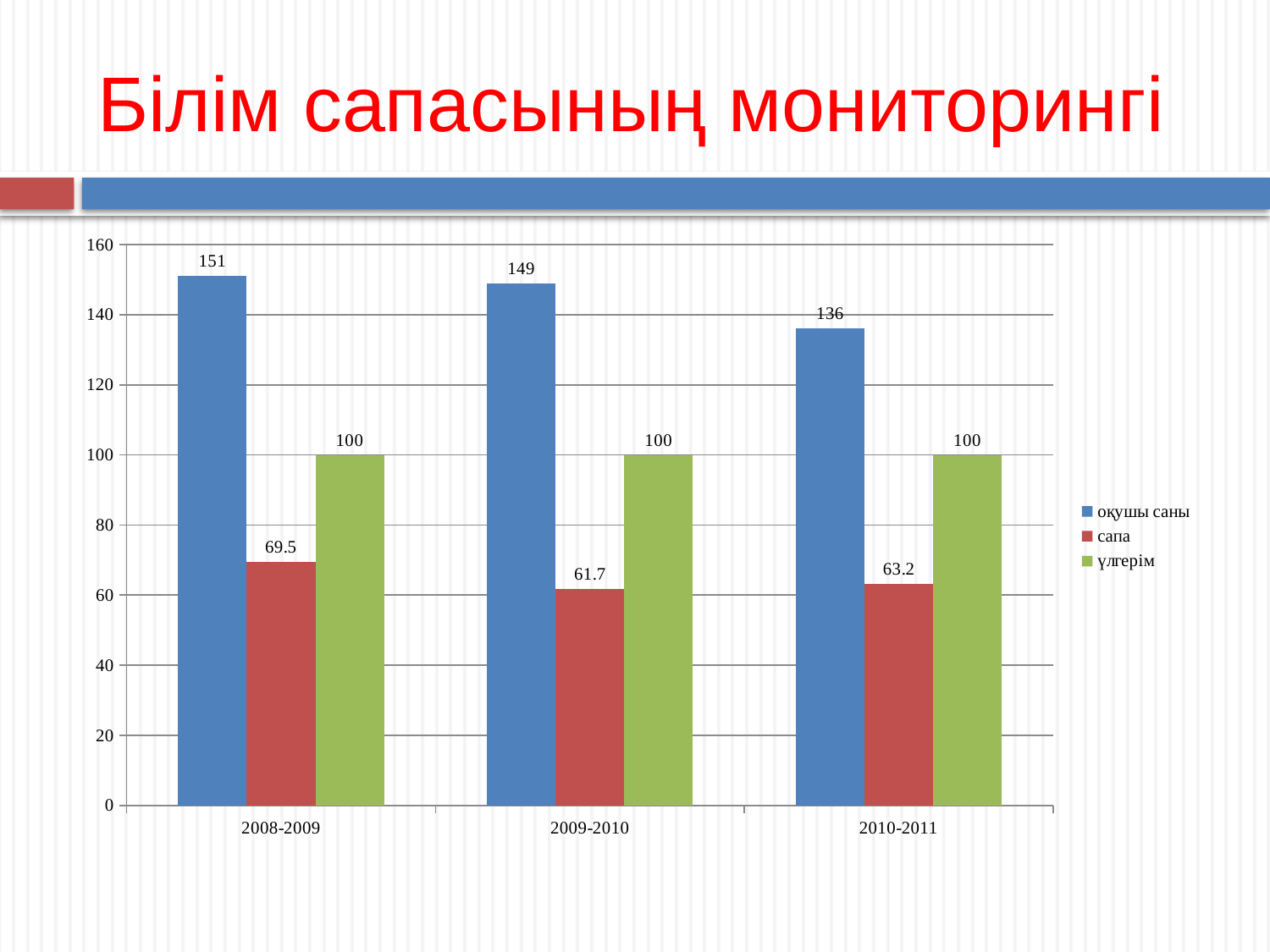
Which year has the lowest value for сапа? 2009-2010 Is the value of оқушы саны for 2010-2011 greater or less than 120? greater Which year has the highest value for оқушы саны? 2008-2009 What is the value of сапа for 2009-2010? 61.7 What is the value of оқушы саны for 2008-2009? 151 Does the value of оқушы саны rise or fall from 2008-2009 to 2010-2011? fall What kind of chart is shown on the slide? bar chart How many series does the legend list? 3 What is the difference between оқушы саны in 2008-2009 and 2010-2011? 15 What is the value of үлгерім for 2010-2011? 100 How many year categories are shown on the x axis? 3 Which is larger: сапа in 2008-2009 or сапа in 2010-2011? 2008-2009